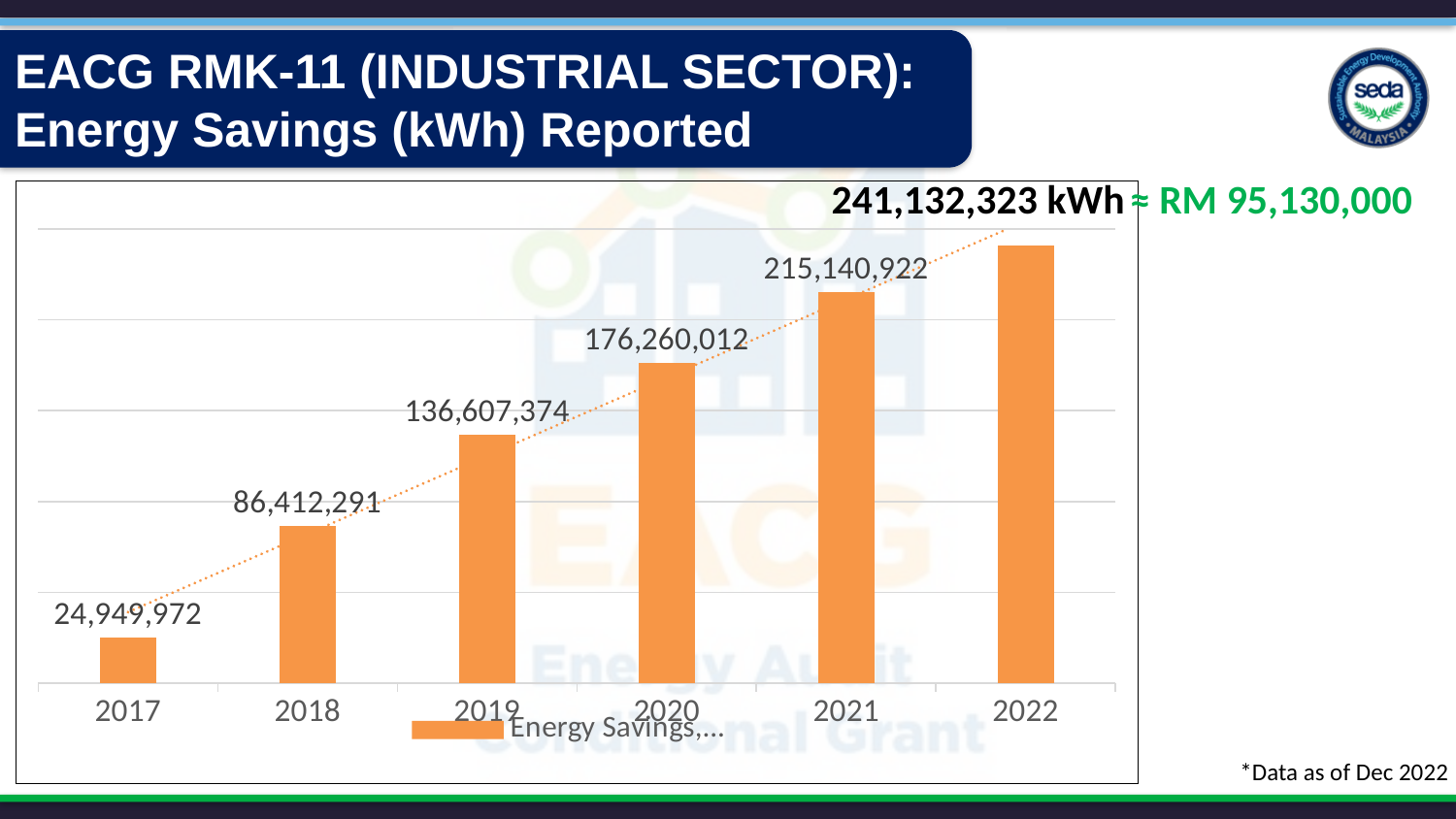
What is the energy savings value reported for 2021? 215,140,922 Which year has the highest reported energy savings? 2022 What is the energy savings value reported for 2017? 24,949,972 What kind of chart is used to show the energy savings? Bar chart What is the difference between the energy savings reported for 2021 and 2020? 38,880,910 How many years are shown on the x axis of the chart? 6 Which year has the lowest reported energy savings? 2017 What is the difference between the energy savings reported for 2018 and 2017? 61,462,319 What is the energy savings value reported for 2022? 241,132,323 kWh Do the reported energy savings rise or fall from 2017 to 2022? Rise Which year has the larger reported energy savings, 2019 or 2020? 2020 What is the energy savings value reported for 2019? 136,607,374